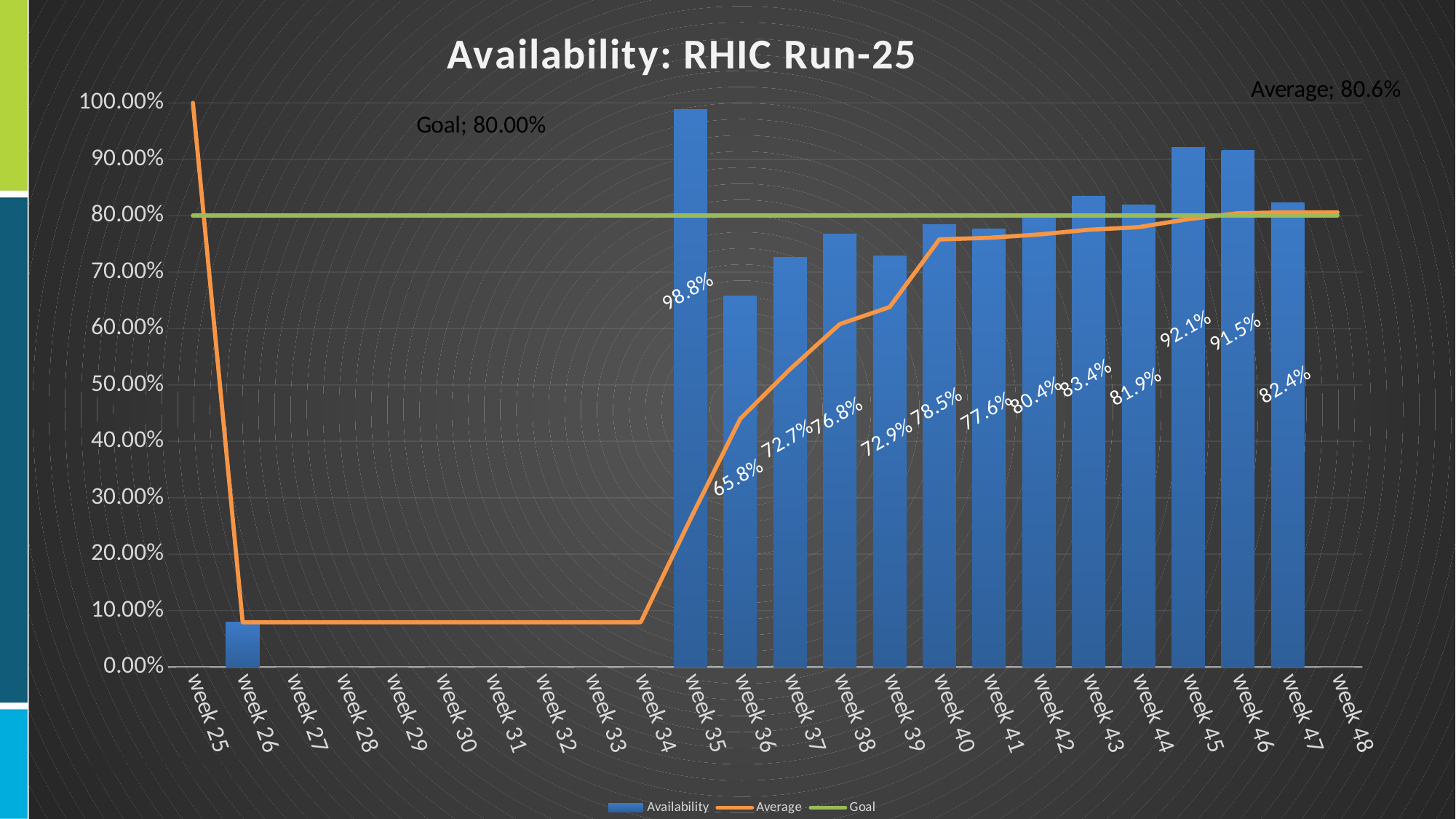
Which has the higher availability, week 43 or week 44? week 43 What is the difference between the availability for week 45 and week 46? 0.6% What is the Average value labelled at the end of the Average line? 80.6% What is the availability value for week 40? 78.5% What is the availability value for week 45? 92.1% What value is shown for the Goal line? 80.00% What is the availability value for week 35? 98.8% What is the difference between the availability for week 35 and week 36? 33.0% How many week categories are shown on the x axis? 24 Is the availability value for week 26 greater or less than 10.00%? less How many series does the legend list? 3 Which week has the highest availability bar? week 35